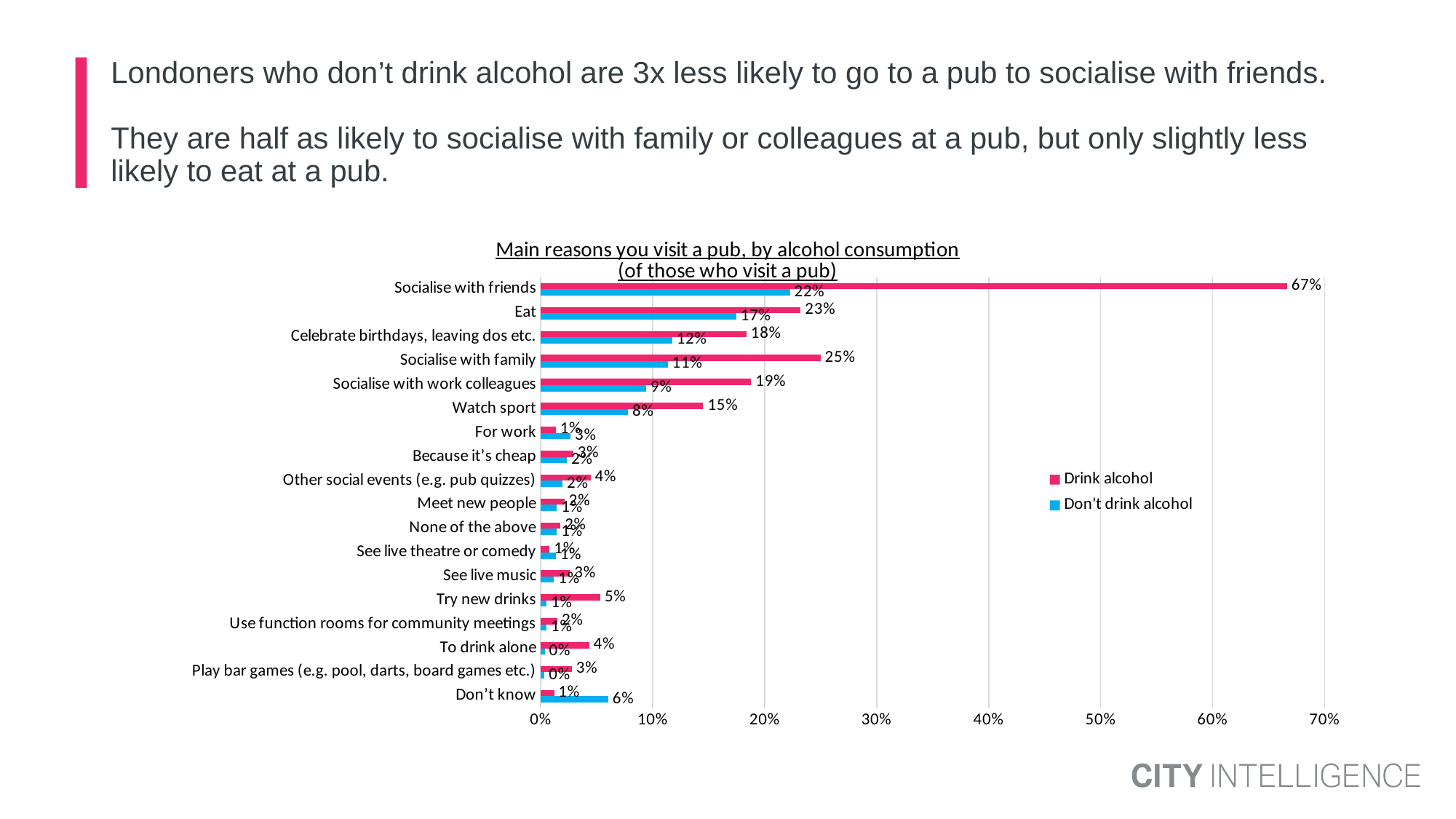
What is the difference between the 'Drink alcohol' and 'Don't drink alcohol' values for 'Watch sport'? 7% Which reason has the highest value for the 'Drink alcohol' series? Socialise with friends What is the difference between the 'Drink alcohol' and 'Don't drink alcohol' values for 'Socialise with friends'? 45% What kind of chart is shown on the slide? Bar chart What percentage of Londoners who drink alcohol say they visit a pub to socialise with friends? 67% What is the value for 'Eat' in the 'Don't drink alcohol' series? 17% What percentage of Londoners who don't drink alcohol say they visit a pub to socialise with friends? 22% Which colour represents the 'Don't drink alcohol' series? Blue For 'Don't know', which series has the larger value: 'Drink alcohol' or 'Don't drink alcohol'? Don't drink alcohol What is the value for 'Socialise with family' in the 'Drink alcohol' series? 25% How many series does the legend list? 2 Is the 'Drink alcohol' value for 'Socialise with friends' greater or less than 60%? greater